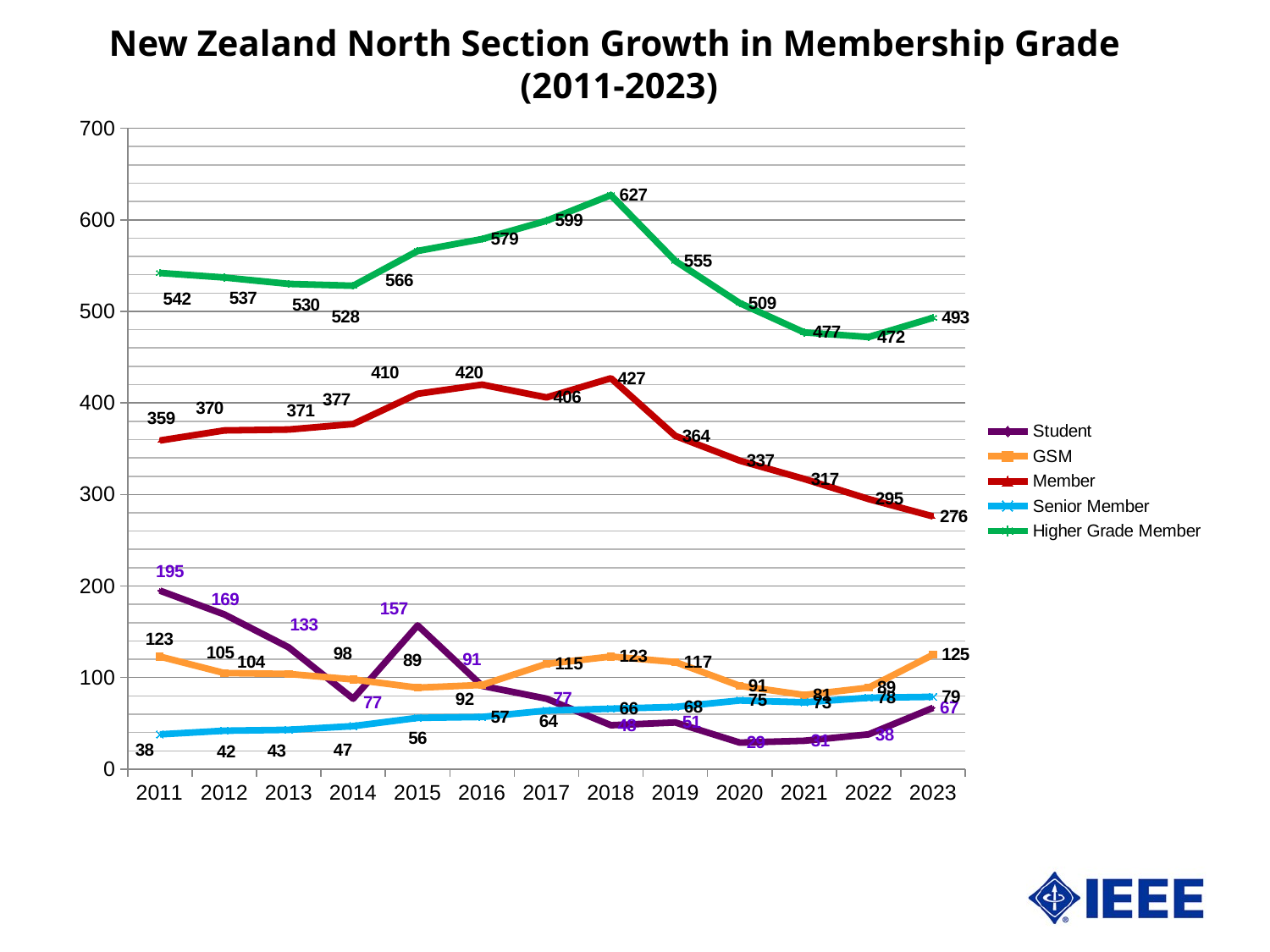
Does the Senior Member series generally rise or fall from 2011 to 2023? rise In which year is the Member series at its lowest value? 2023 Is the Higher Grade Member value for 2021 greater or less than 500? less What is the Higher Grade Member value in 2018? 627 In 2023, which is larger: the GSM value or the Student value? GSM What is the Senior Member value in 2011? 38 In which year does the Higher Grade Member series reach its highest value? 2018 What is the Student value in 2011? 195 What is the difference between the Member value in 2018 and in 2023? 151 How many series does the legend list? 5 What kind of chart is shown on the slide? line chart How many years are plotted along the x axis? 13